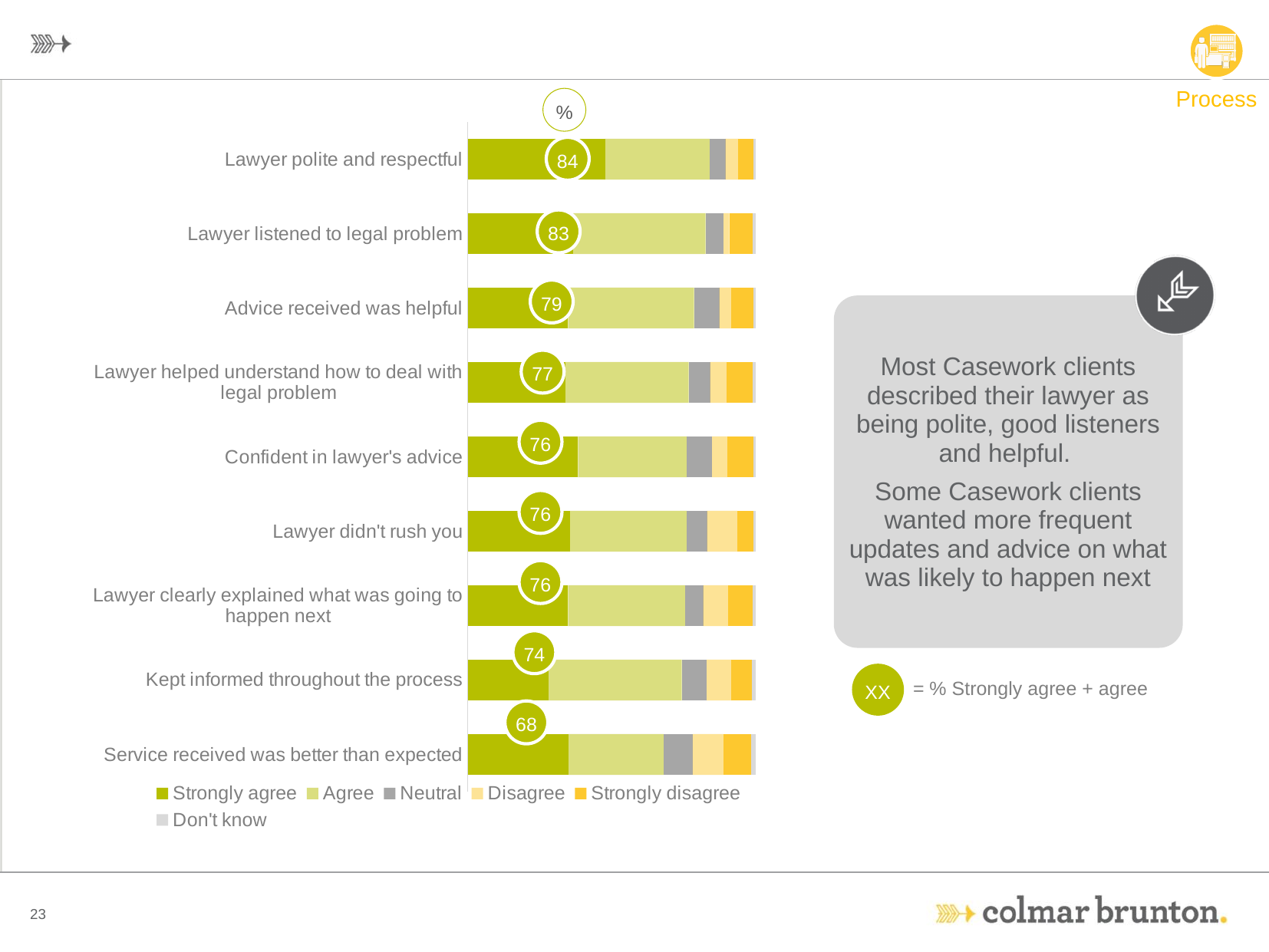
How many statements share a combined agreement percentage of 76? 3 Which statement has the lowest combined strongly agree + agree percentage? Service received was better than expected Which statement has the highest combined strongly agree + agree percentage? Lawyer polite and respectful How many series does the legend list? 6 What is the combined percentage of strongly agree and agree for "Advice received was helpful"? 79 What is the combined percentage of strongly agree and agree for "Kept informed throughout the process"? 74 How many statements are plotted in the chart? 9 Which has a higher combined agreement percentage: "Lawyer listened to legal problem" or "Lawyer helped understand how to deal with legal problem"? Lawyer listened to legal problem What is the difference between the combined agreement percentages for "Lawyer polite and respectful" and "Service received was better than expected"? 16 What kind of chart is shown on the slide? Stacked bar chart What is the combined percentage of strongly agree and agree for "Lawyer polite and respectful"? 84 According to the key on the slide, what does the number in the circle on each bar represent? % Strongly agree + agree